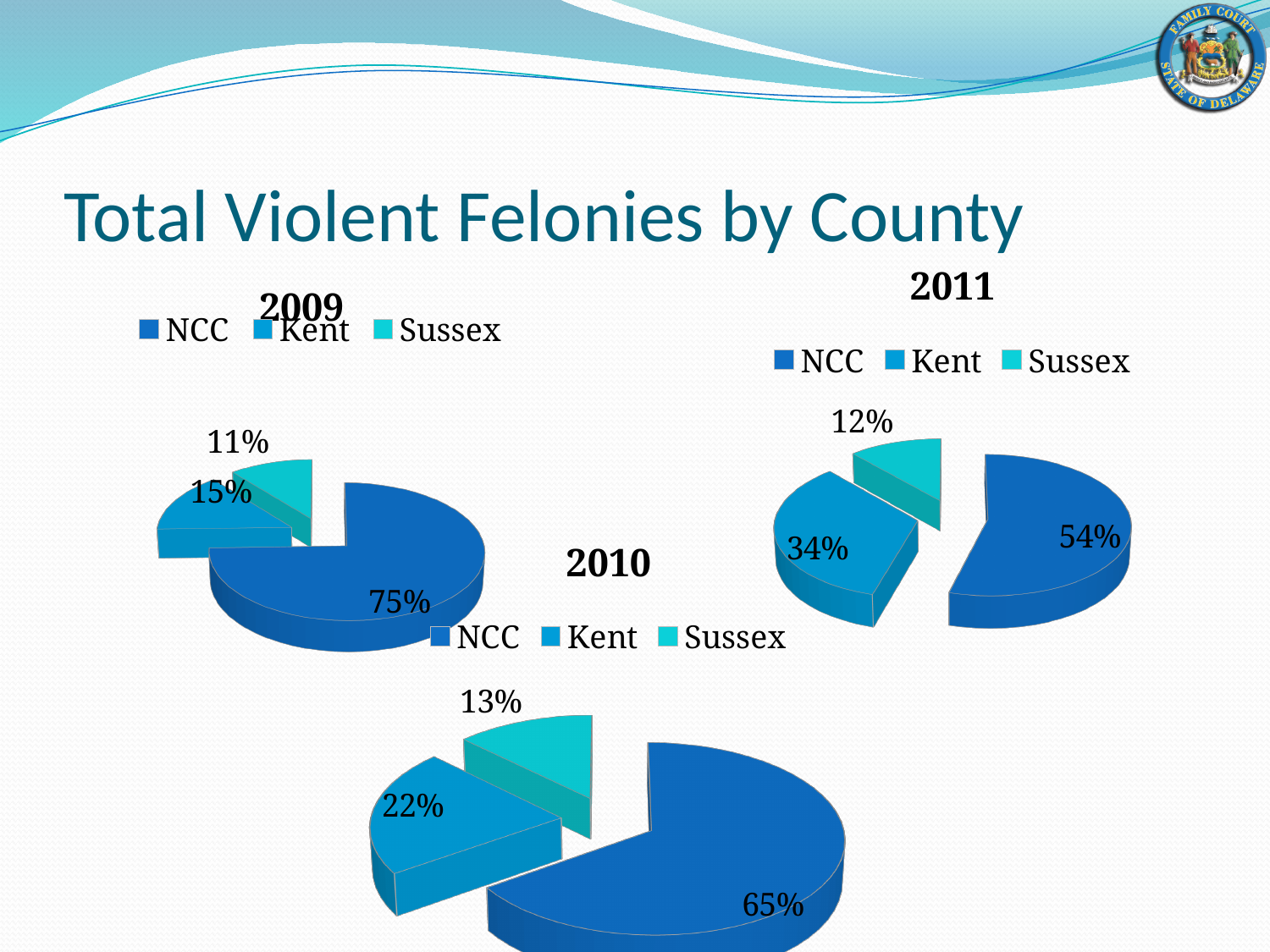
In the 2009 pie chart, what share does NCC have? 75% In the 2010 pie chart, what share does Sussex have? 13% In the 2010 pie chart, which county has the smallest share? Sussex What kind of chart is used for the 2010 data? Pie chart In the 2010 pie chart, which is larger, the Kent share or the Sussex share? Kent In the 2011 pie chart, what share does Kent have? 34% How many counties does the legend of the 2009 chart list? 3 In the 2011 pie chart, what is the difference between the NCC share and the Kent share? 20% How many pie charts are on the slide? 3 Across the 2009, 2010 and 2011 charts, does the NCC share rise or fall over the years? Fall In the 2009 pie chart, what share does Kent have? 15% In the 2011 pie chart, which county has the largest share? NCC